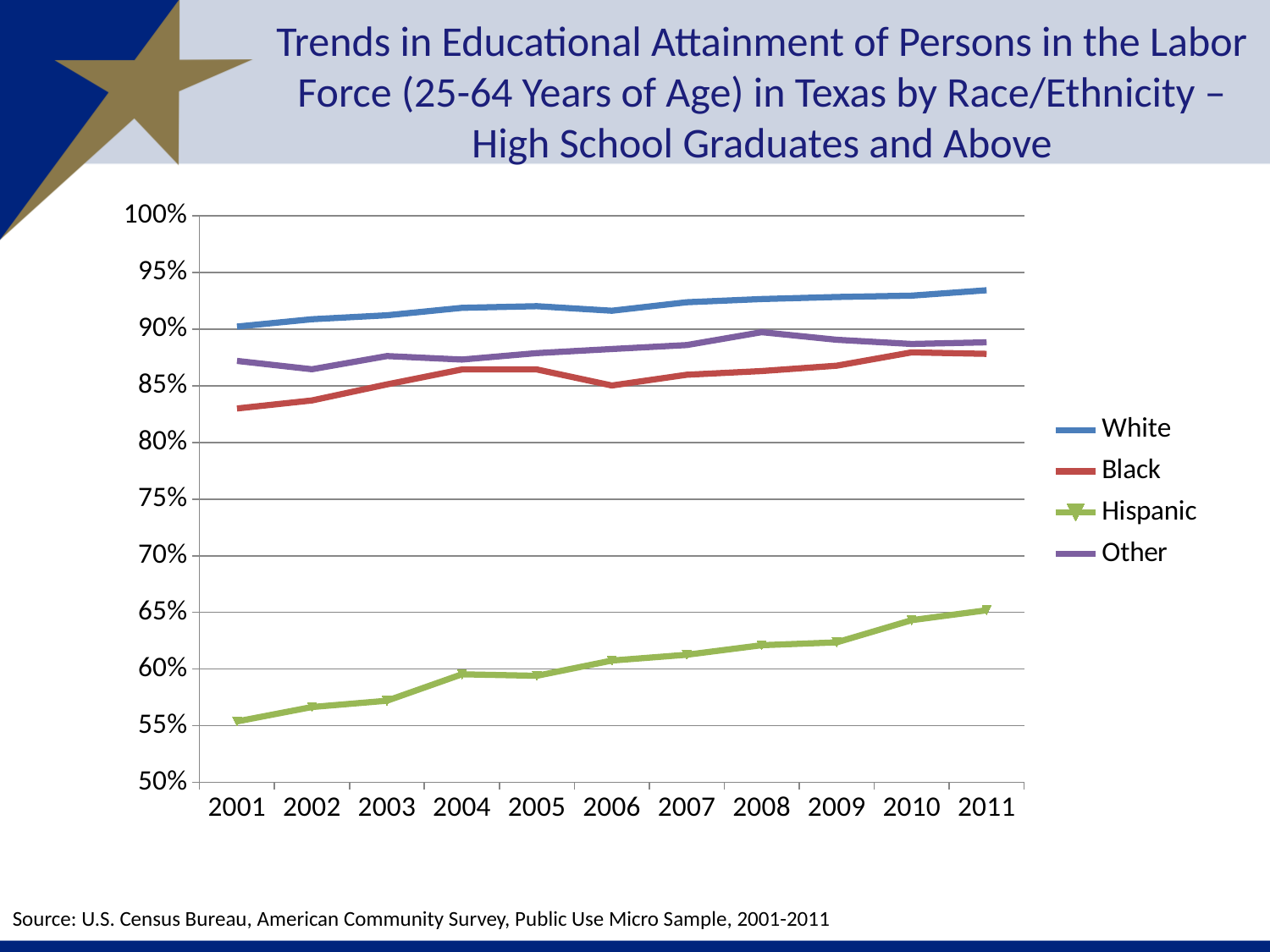
Is the value for White in 2011 greater or less than 90%? greater How many series does the legend list? 4 Which series is drawn in green? Hispanic Which series has the highest values across all years? White What kind of chart is shown on the slide? line chart Is the value for Hispanic in 2001 greater or less than 60%? less Does the Hispanic series rise or fall from 2001 to 2011? rise Is the value for Black in 2001 greater or less than 85%? less How many years are shown along the x axis? 11 Which series has the lowest values across all years? Hispanic In 2006, which is larger, the value for Black or the value for Other? Other